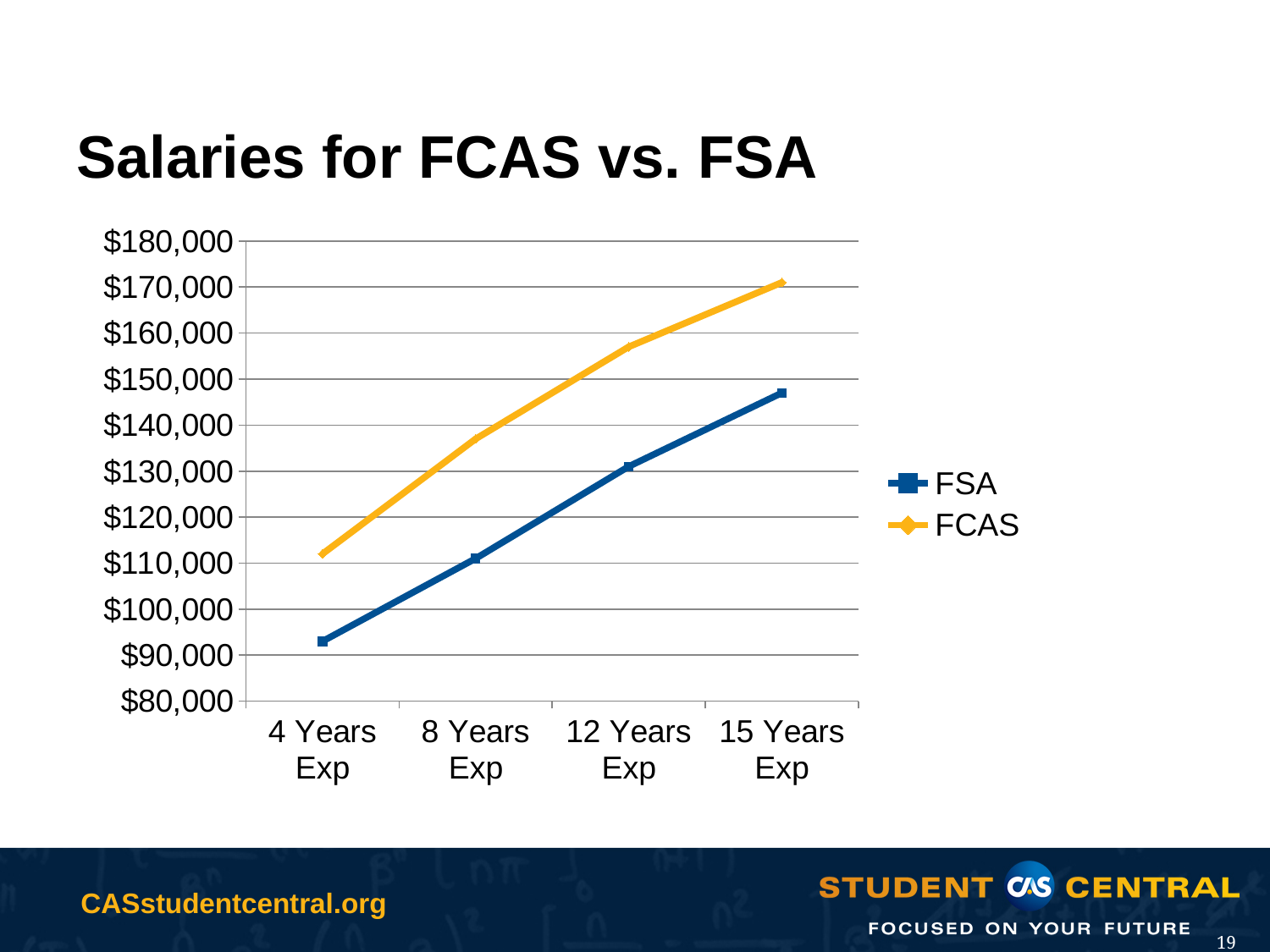
What type of chart is shown on the slide? line chart At 12 Years Exp, which series has the higher salary, FSA or FCAS? FCAS Is the FSA value at 12 Years Exp greater or less than $120,000? greater Is the FCAS value at 15 Years Exp greater or less than $160,000? greater Is the FSA value at 4 Years Exp greater or less than $100,000? less At which experience level is the FCAS salary highest? 15 Years Exp How many experience-level categories are shown on the x axis? 4 Which series is shown in yellow? FCAS How many series does the legend list? 2 What is the title of the chart? Salaries for FCAS vs. FSA At which experience level is the FSA salary lowest? 4 Years Exp